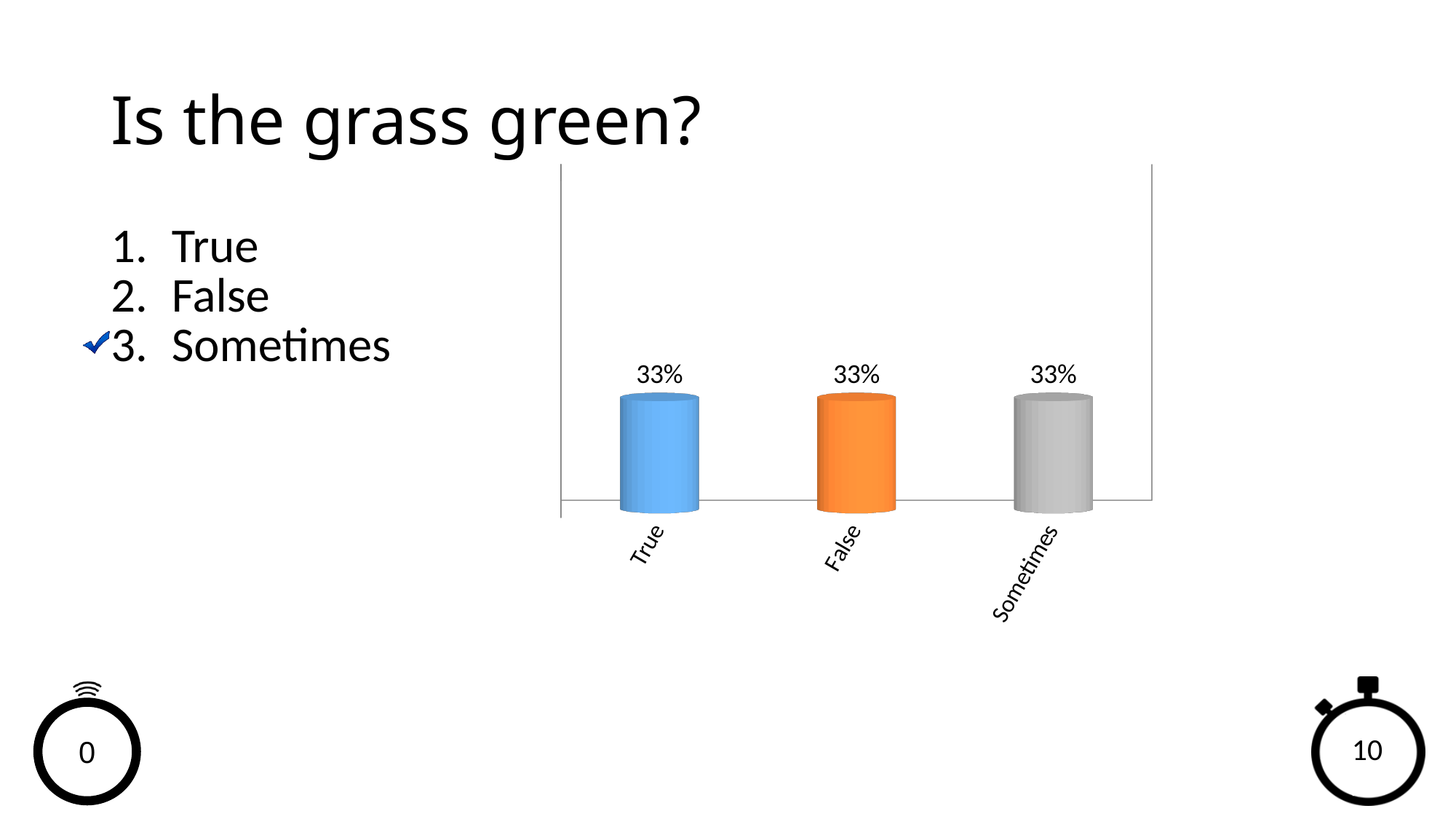
What colour is the bar for False? orange How many categories are shown on the chart? 3 What is the value for True? 33% What is the value for False? 33% What kind of chart is shown on the slide? bar chart Do the values rise, fall, or stay the same across the categories from True to Sometimes? stay the same Are the values for True and Sometimes equal? yes What is the value for Sometimes? 33% What is the difference between the values for True and False? 0% What colour is the bar for True? blue